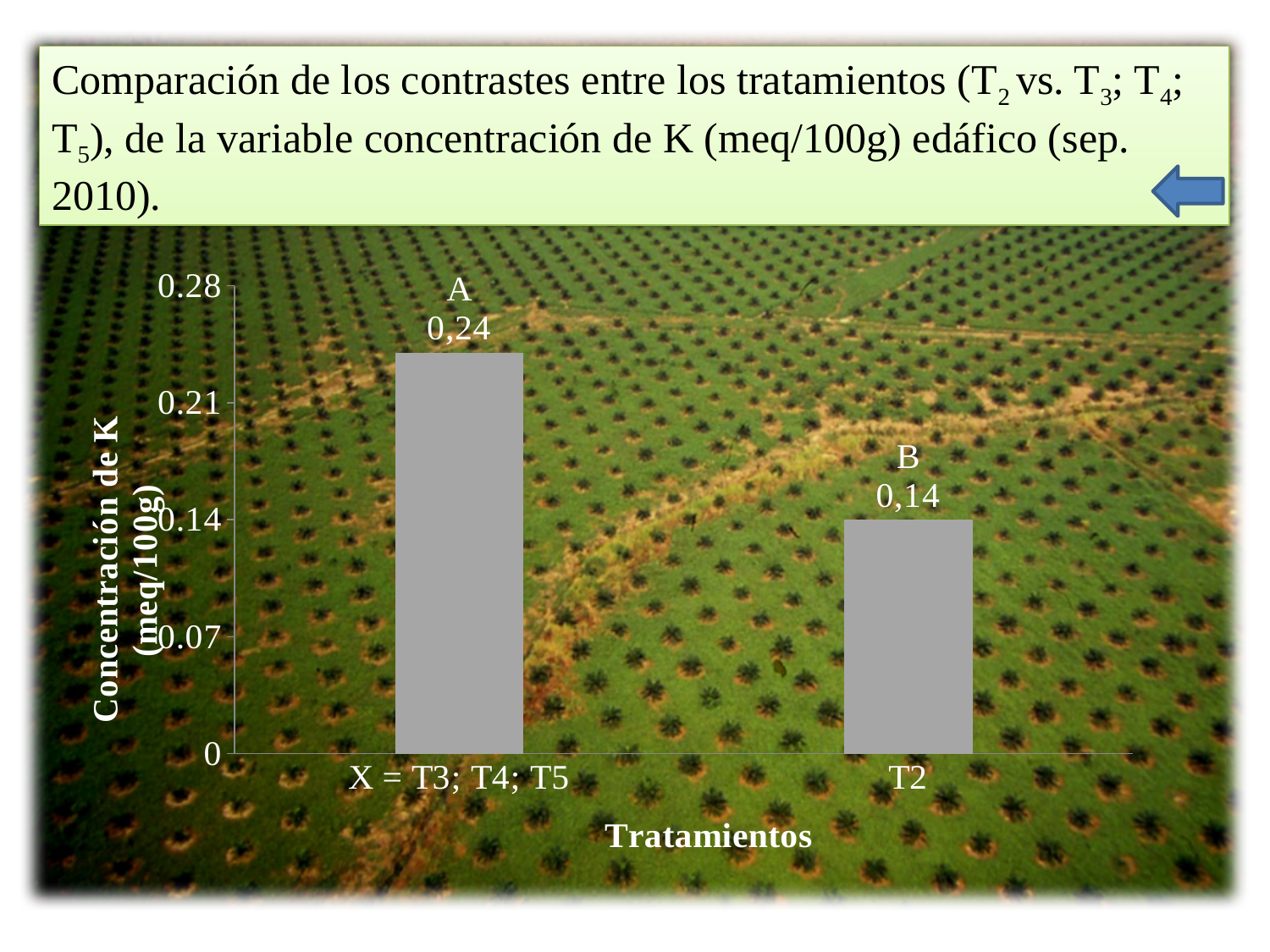
What is the K concentration value for the category 'X = T3; T4; T5'? 0,24 Is the value for T2 greater or less than 0.21? less How many categories are shown on the x axis? 2 What statistical group letter is shown above the T2 bar? B What kind of chart is shown on the slide? bar chart Which category has the lowest K concentration? T2 Is the value for 'X = T3; T4; T5' greater or less than 0.21? greater Which has a larger K concentration, 'X = T3; T4; T5' or T2? X = T3; T4; T5 What is the label of the x axis? Tratamientos What is the difference between the K concentration for 'X = T3; T4; T5' and for T2? 0,10 Which category has the highest K concentration? X = T3; T4; T5 What is the K concentration value for treatment T2? 0,14